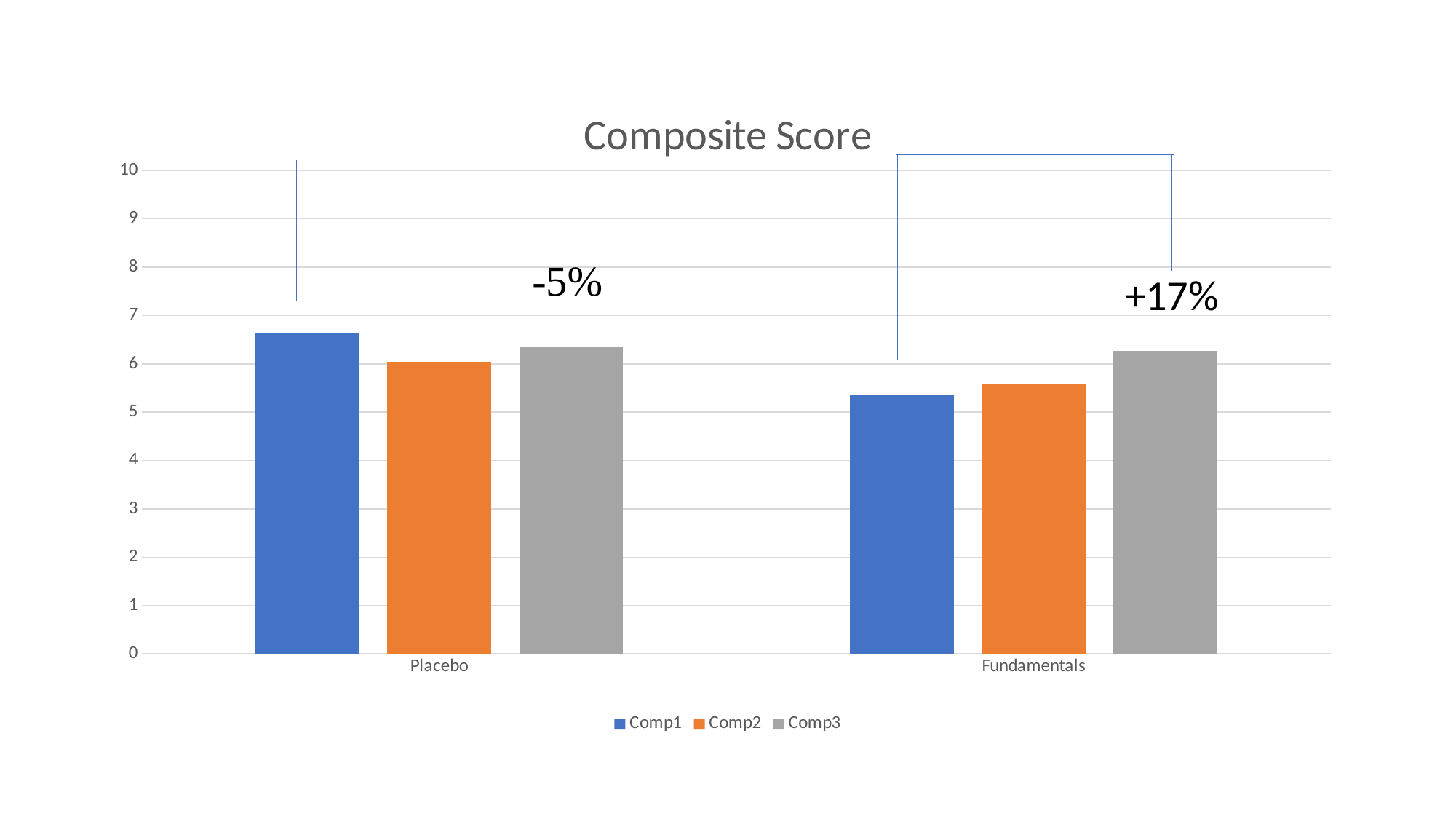
Which series has the lowest value for Fundamentals? Comp1 What type of chart is shown on the slide? bar chart How many categories are shown on the x axis? 2 Which is larger: Comp1 for Placebo or Comp1 for Fundamentals? Comp1 for Placebo What percentage annotation is shown above the Fundamentals bars? +17% Is the value for Comp1 under Fundamentals greater or less than 6? less Which series has the highest value for Fundamentals? Comp3 Is the value for Comp1 under Placebo greater or less than 6? greater Is the value for Comp2 under Fundamentals greater or less than 5? greater How many series does the legend list? 3 Which series has the highest value for Placebo? Comp1 What is the title of the chart? Composite Score